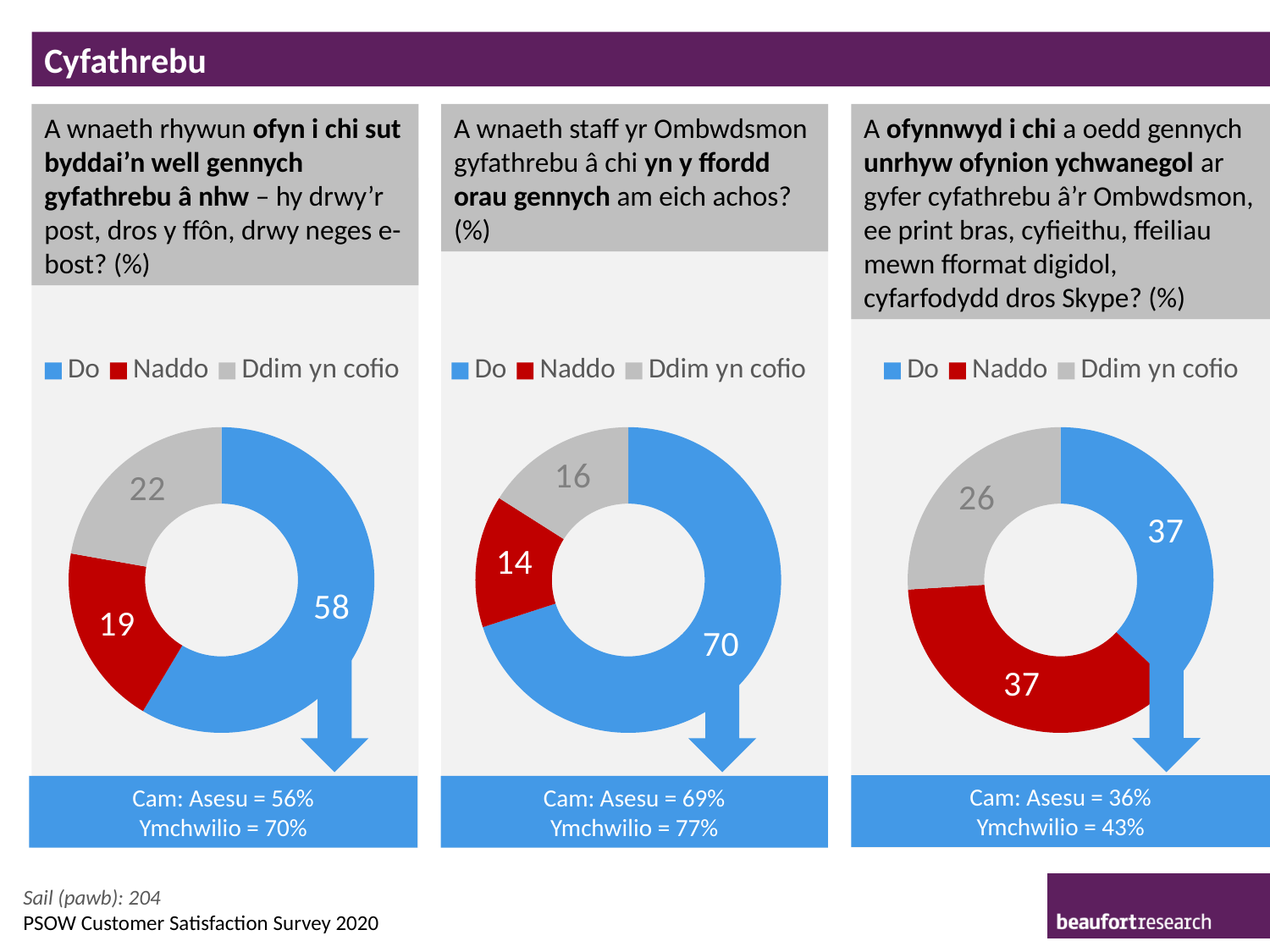
In the right-hand donut chart, what is the difference between the values for 'Do' and 'Ddim yn cofio'? 11 In the middle donut chart, what is the difference between the values for 'Do' and 'Naddo'? 56 In the middle donut chart, what is the value for 'Ddim yn cofio'? 16 In the left-hand donut chart, which is larger: 'Ddim yn cofio' or 'Naddo'? Ddim yn cofio What kind of chart is used in the middle panel of the slide? Donut chart In the right-hand donut chart, what is the value for 'Ddim yn cofio'? 26 In the left-hand donut chart, which category has the lowest value? Naddo In the right-hand donut chart, what colour is the 'Naddo' segment? Red In the left-hand donut chart, what is the value for 'Do'? 58 How many series does the legend of the right-hand donut chart list? 3 In the middle donut chart, which category has the highest value? Do In the left-hand donut chart, what is the value for 'Naddo'? 19